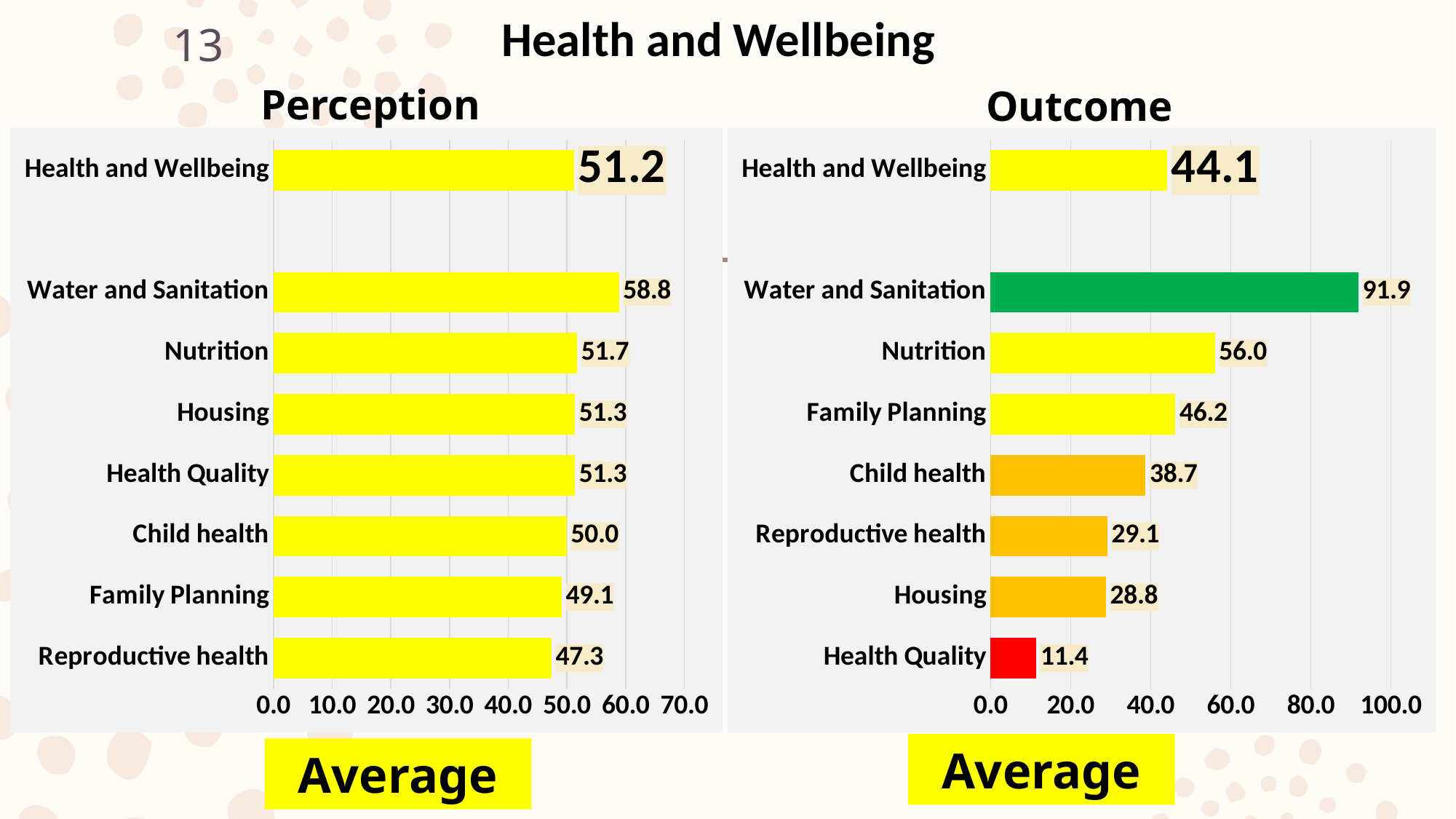
In the Perception chart, is the value for Child health greater or less than 40.0? greater In the Outcome chart, what is the value for Health Quality? 11.4 In the Outcome chart, what is the value for Health and Wellbeing? 44.1 In the Outcome chart, what is the difference between Water and Sanitation and Nutrition? 35.9 In the Perception chart, which category has the lowest value? Reproductive health How many bars are shown in the Outcome chart? 8 In the Outcome chart, what colour is the Water and Sanitation bar? Green In the Outcome chart, which category has the highest value? Water and Sanitation What type of chart is the Perception chart? Bar chart In the Outcome chart, which is larger, Child health or Family Planning? Family Planning In the Perception chart, what is the difference between Health and Wellbeing and Reproductive health? 3.9 In the Perception chart, what is the value for Water and Sanitation? 58.8